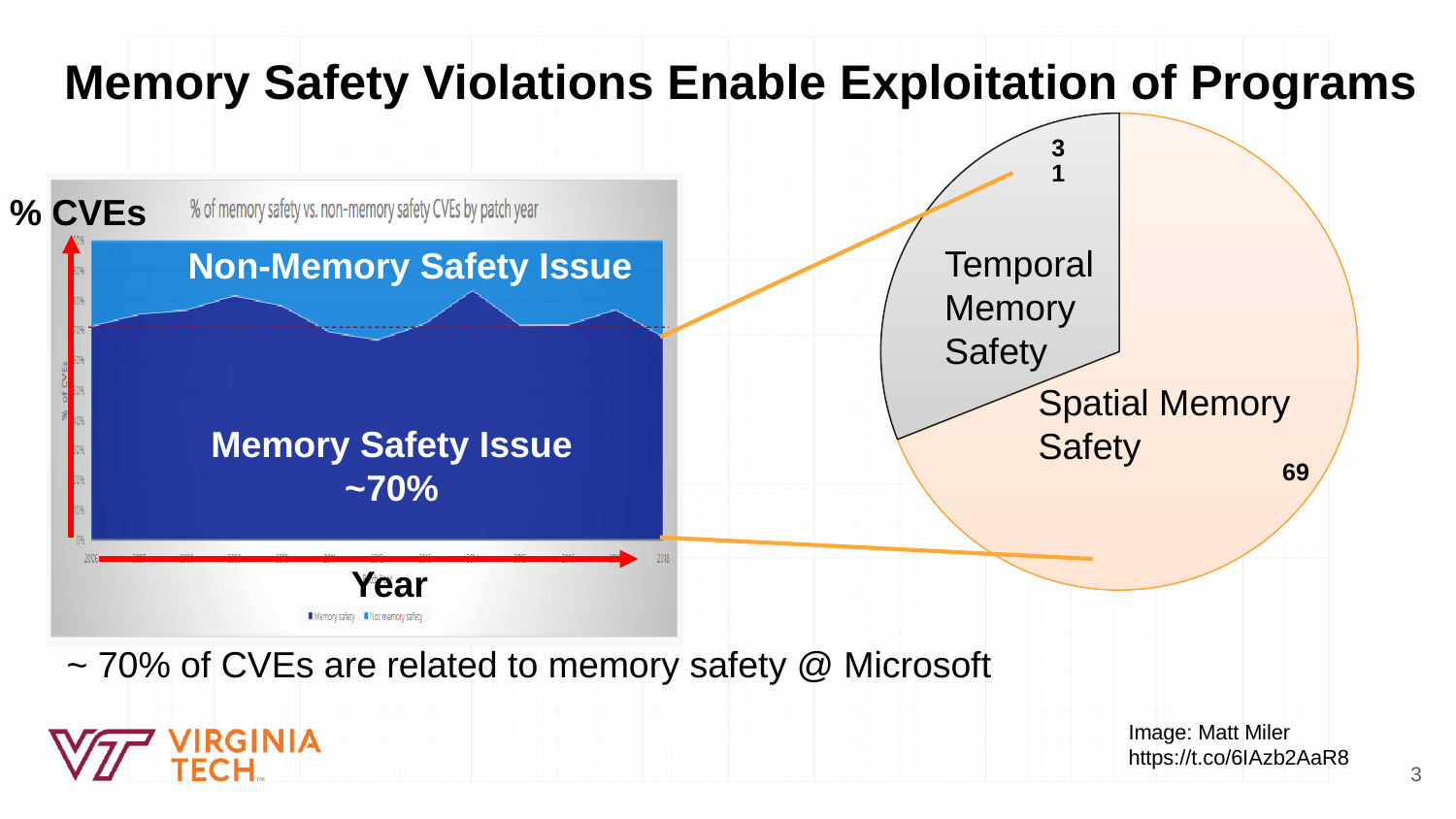
In the pie chart on the right, what is the value for Temporal Memory Safety? 31 In the pie chart on the right, what share of the total does Spatial Memory Safety represent? 69% In the pie chart on the right, how many slices are there? 2 What kind of chart is the chart on the left of the slide? area chart In the pie chart on the right, which slice is the largest? Spatial Memory Safety In the chart on the left, how many series does the legend list? 2 In the pie chart on the right, what is the value for Spatial Memory Safety? 69 What kind of chart is the chart on the right of the slide? pie chart In the chart on the left, is the share of CVEs that are memory safety issues greater or less than 50%? greater What is the label on the x axis of the chart on the left? Year In the pie chart on the right, what is the difference between the Spatial Memory Safety and Temporal Memory Safety values? 38 In the chart on the left, which is larger across the years: the Memory Safety Issue share or the Non-Memory Safety Issue share? Memory Safety Issue